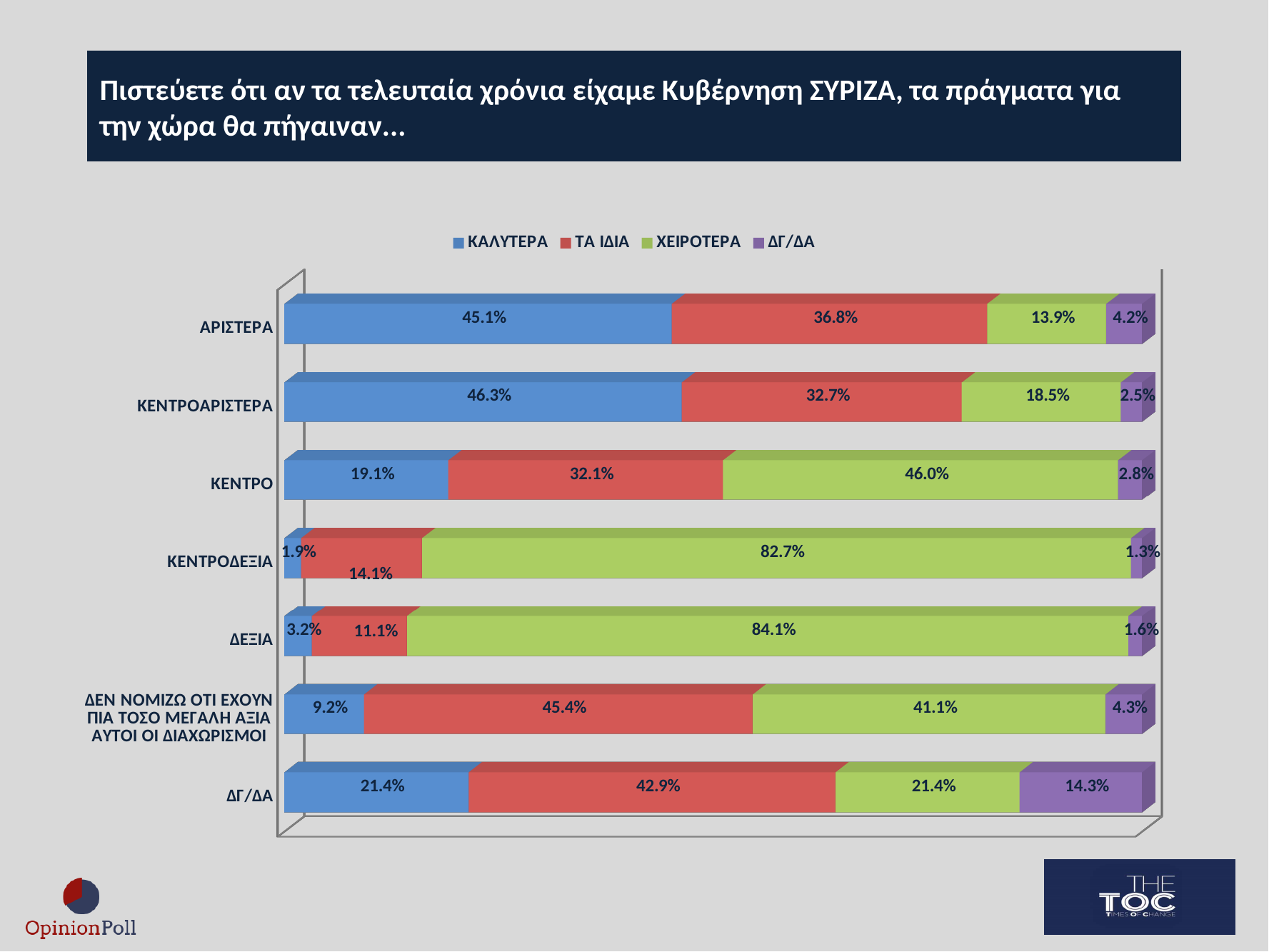
Which colour represents ΧΕΙΡΟΤΕΡΑ in the chart? Green How many series does the legend list? 4 Which category has the lowest ΚΑΛΥΤΕΡΑ value? ΚΕΝΤΡΟΔΕΞΙΑ What is the ΤΑ ΙΔΙΑ value for ΚΕΝΤΡΟΔΕΞΙΑ? 14.1% What is the ΔΓ/ΔΑ value for the ΔΓ/ΔΑ category? 14.3% What is the difference between the ΧΕΙΡΟΤΕΡΑ and ΚΑΛΥΤΕΡΑ values for ΚΕΝΤΡΟ? 26.9% What is the ΧΕΙΡΟΤΕΡΑ value for ΚΕΝΤΡΟ? 46.0% What kind of chart is shown on the slide? Stacked bar chart How many categories are shown on the chart? 7 Which is larger: the ΚΑΛΥΤΕΡΑ value for ΑΡΙΣΤΕΡΑ or for ΚΕΝΤΡΟΑΡΙΣΤΕΡΑ? ΚΕΝΤΡΟΑΡΙΣΤΕΡΑ Which category has the highest ΧΕΙΡΟΤΕΡΑ value? ΔΕΞΙΑ What percentage of ΑΡΙΣΤΕΡΑ respondents answered ΚΑΛΥΤΕΡΑ? 45.1%